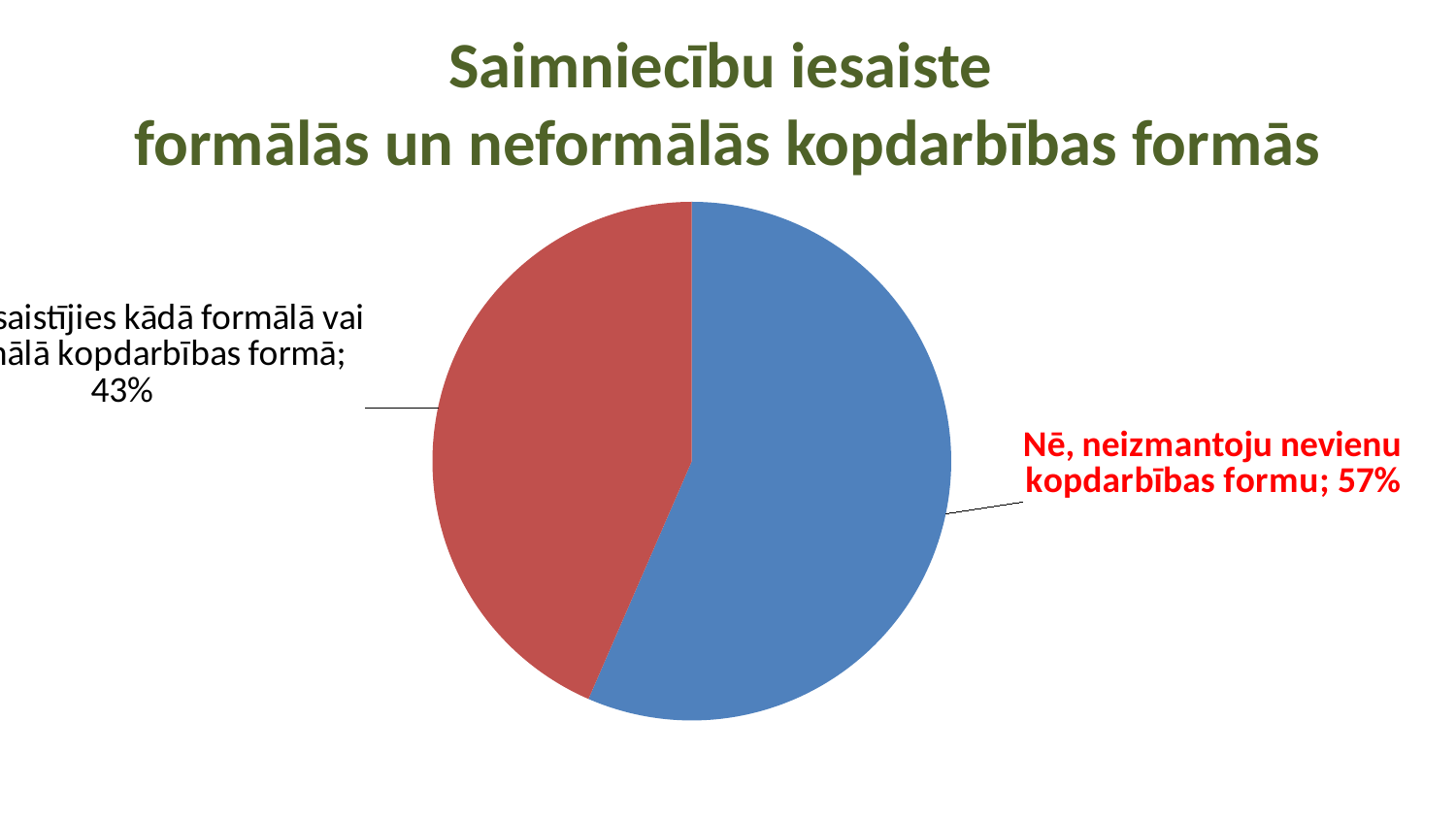
Which is larger: the blue slice or the red slice? the blue slice What is the title of the chart on the slide? Saimniecību iesaiste formālās un neformālās kopdarbības formās What percentage is shown for the red slice of the pie? 43% What kind of chart is shown on the slide? pie chart How many slices does the pie chart have? 2 What colour is the slice labelled "Nē, neizmantoju nevienu kopdarbības formu; 57%"? blue Is the share for "Nē, neizmantoju nevienu kopdarbības formu" greater or less than 50%? greater What share of the pie is labelled "Nē, neizmantoju nevienu kopdarbības formu"? 57% What is the difference in percentage points between the 57% slice and the 43% slice? 14 Which slice is the largest in the pie chart? Nē, neizmantoju nevienu kopdarbības formu